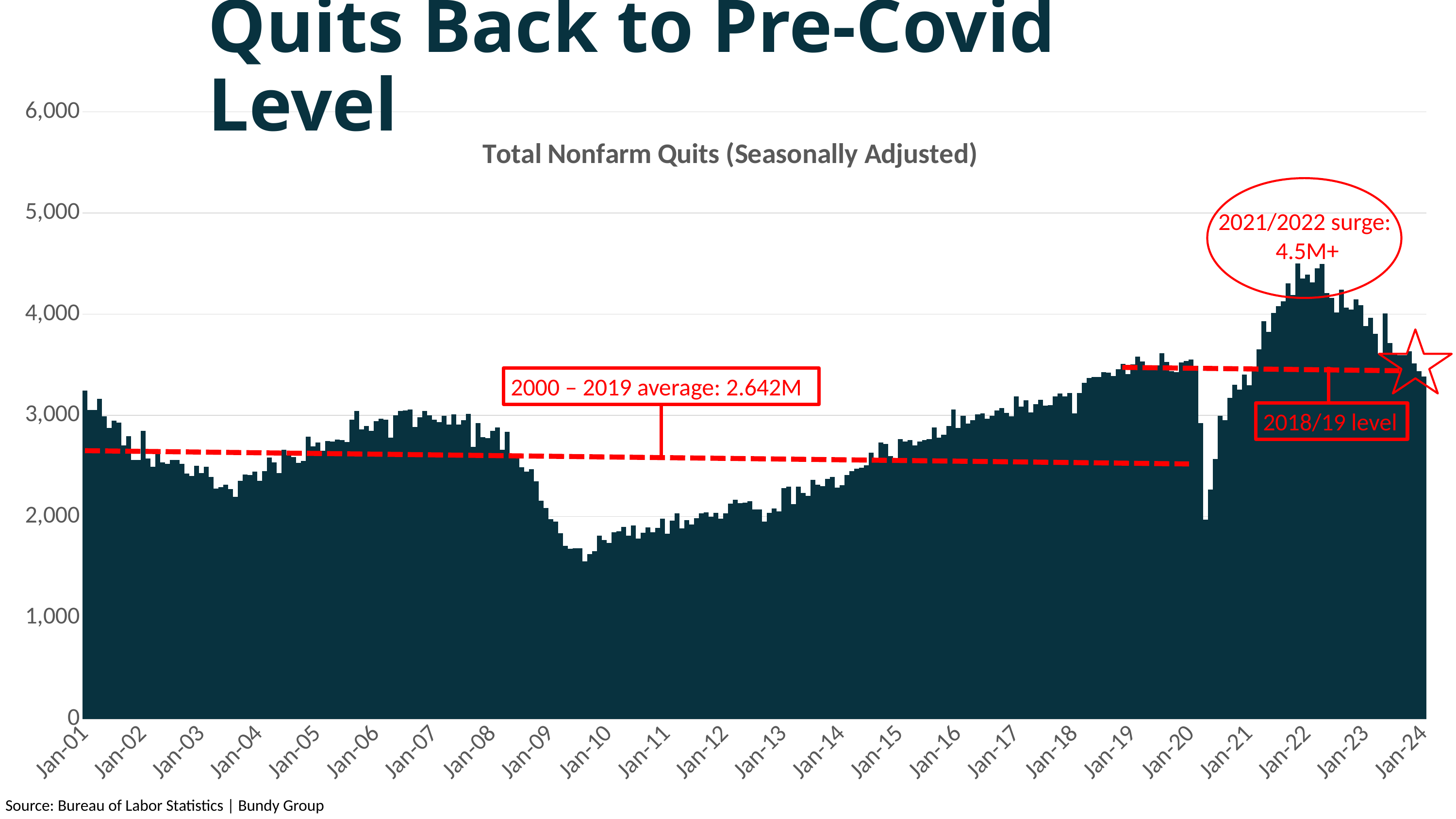
What is the title of the chart? Total Nonfarm Quits (Seasonally Adjusted) Is the value at Jan-22 greater or less than 4,000? greater Is the value at Jan-10 greater or less than 2,000? less How many year labels are shown on the x axis? 24 Is the value at Jan-13 greater or less than 2,500? less Near which x-axis label does the chart reach its lowest value? Jan-10 What kind of chart is shown on the slide? bar chart What 2000 – 2019 average value is annotated on the chart? 2.642M Do the values generally rise or fall between Jan-10 and Jan-19? rise What value does the annotation give for the 2021/2022 surge? 4.5M+ Near which x-axis label does the chart reach its highest value? Jan-22